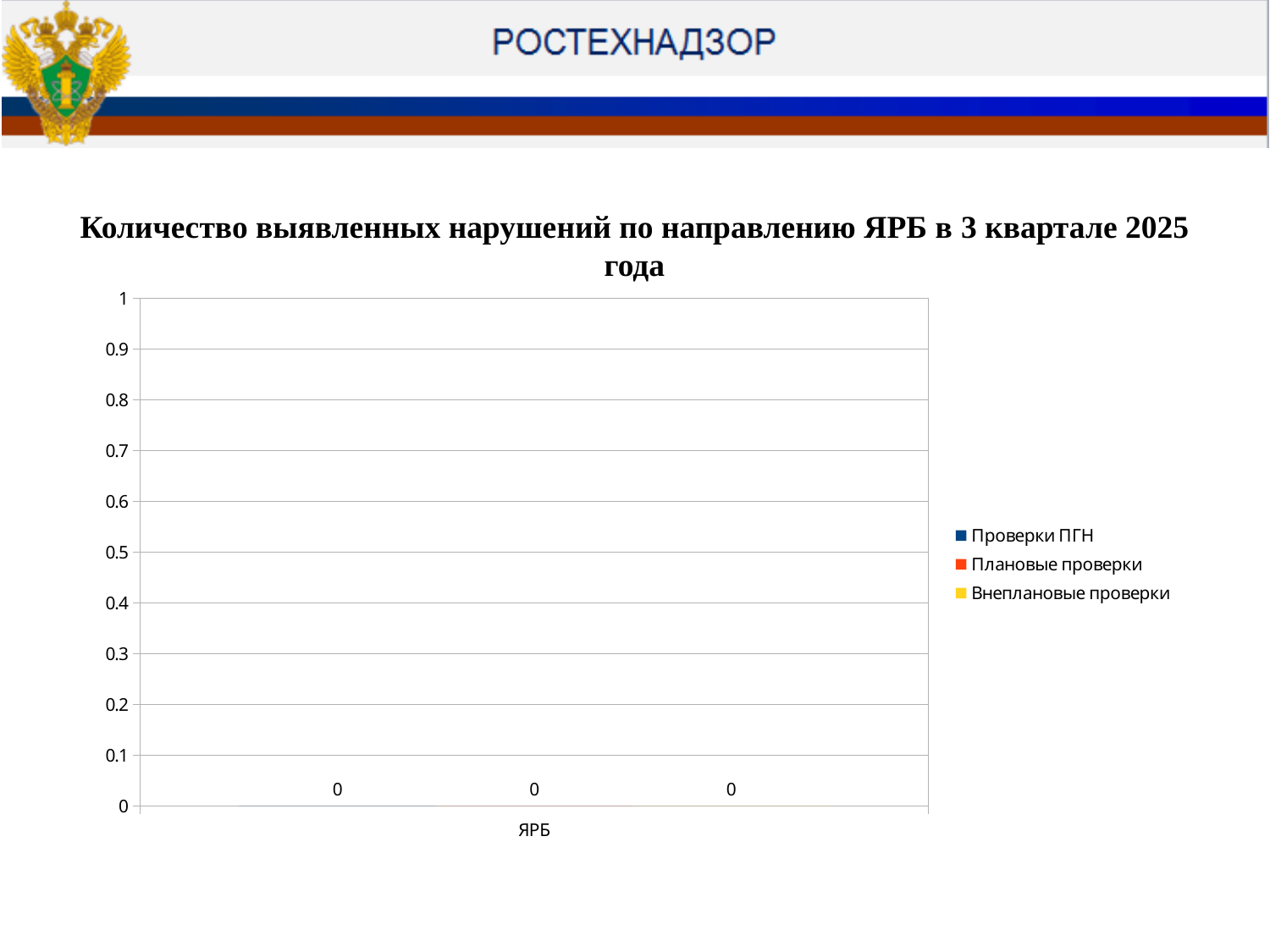
Which series is listed first in the legend? Проверки ПГН What is the value for Проверки ПГН in the ЯРБ category? 0 Is the value for Внеплановые проверки greater or less than 0.5? less How many categories are shown on the x axis? 1 What is the value for Внеплановые проверки in the ЯРБ category? 0 What kind of chart is shown on the slide? bar chart What is the value for Плановые проверки in the ЯРБ category? 0 What is the title of the chart? Количество выявленных нарушений по направлению ЯРБ в 3 квартале 2025 года What is the label of the category on the x axis? ЯРБ What is the difference between the Проверки ПГН value and the Плановые проверки value for ЯРБ? 0 How many series does the legend list? 3 What is the total of the three series values for ЯРБ? 0